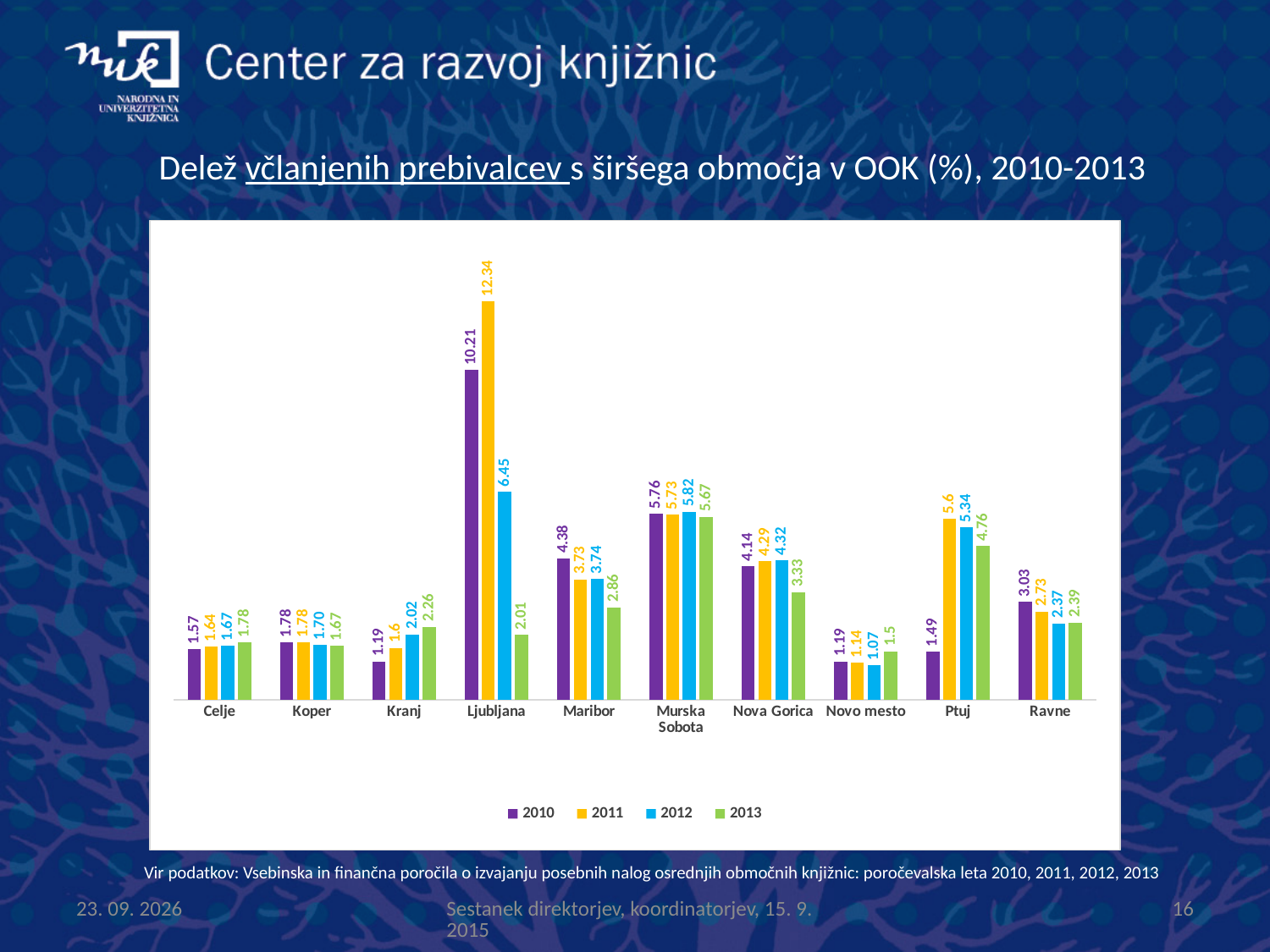
Which is larger, the 2012 value for Maribor or the 2012 value for Nova Gorica? Nova Gorica Do the values for Kranj rise or fall from 2010 to 2013? rise What is the value for Novo mesto in 2012? 1.07 What type of chart is shown on the slide? bar chart What is the difference between the 2011 and 2013 values for Ljubljana? 10.33 How many series does the legend list? 4 Which colour represents the 2011 series in the legend? yellow How many libraries (categories) are shown on the x axis? 10 What is the value for Ptuj in 2013? 4.76 Which library has the highest value in 2010? Ljubljana What is the value for Ljubljana in 2011? 12.34 Which library has the lowest value in 2013? Novo mesto